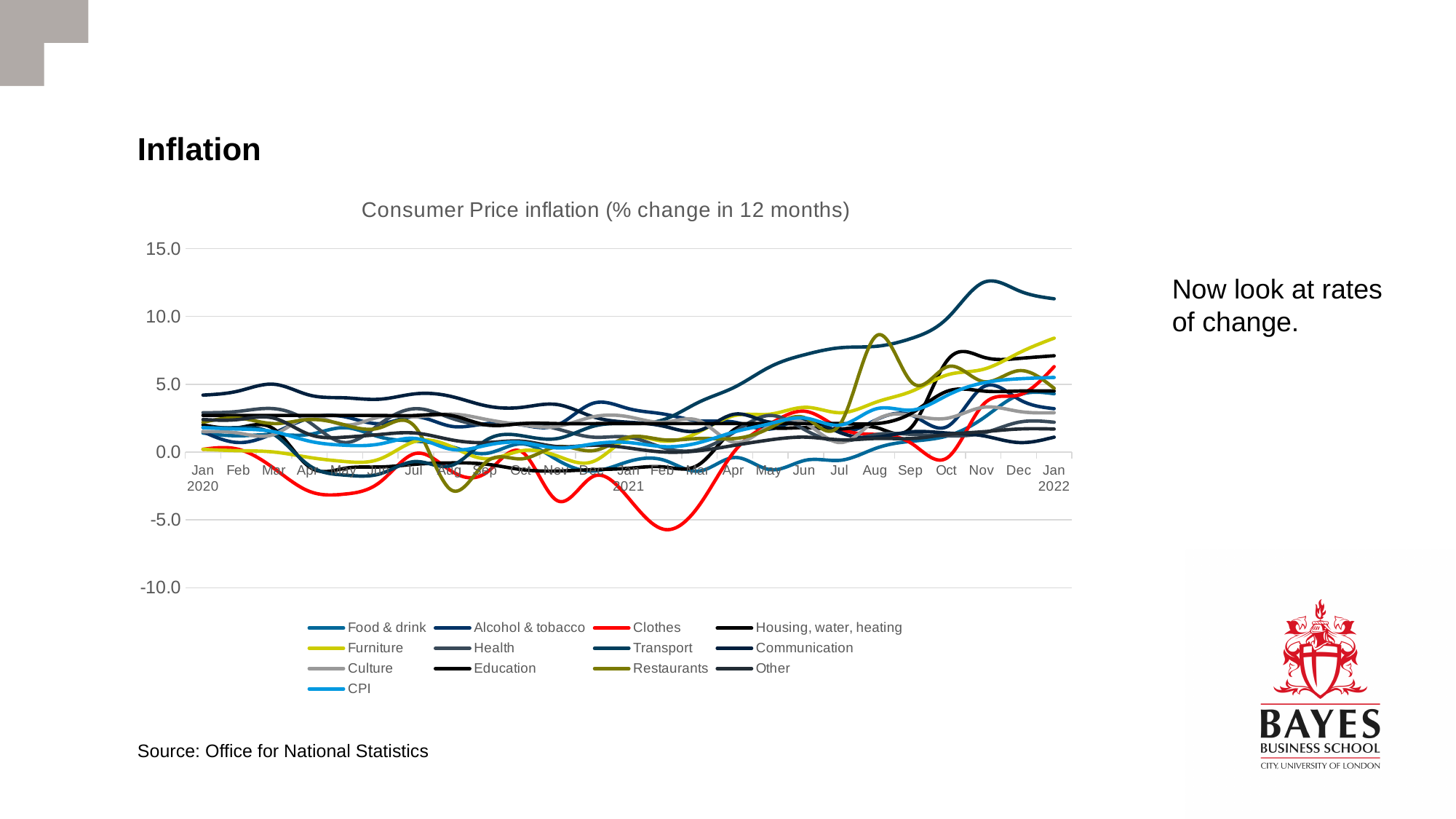
At Jan 2022, which is larger: Transport or Furniture? Transport What kind of chart is shown on the slide? line chart Is the value for Transport at Nov 2021 greater or less than 10.0? greater What is the title of the chart? Consumer Price inflation (% change in 12 months) How many series does the legend list? 13 Is the value for Furniture at Jan 2022 greater or less than 5.0? greater Is the value for Restaurants at Aug 2021 greater or less than 5.0? greater Does the Transport series rise or fall between Jan 2021 and Jan 2022? rise What is the source cited for the chart? Office for National Statistics Which series has the highest value at Jan 2022? Transport Which series reaches the lowest value anywhere on the chart? Clothes